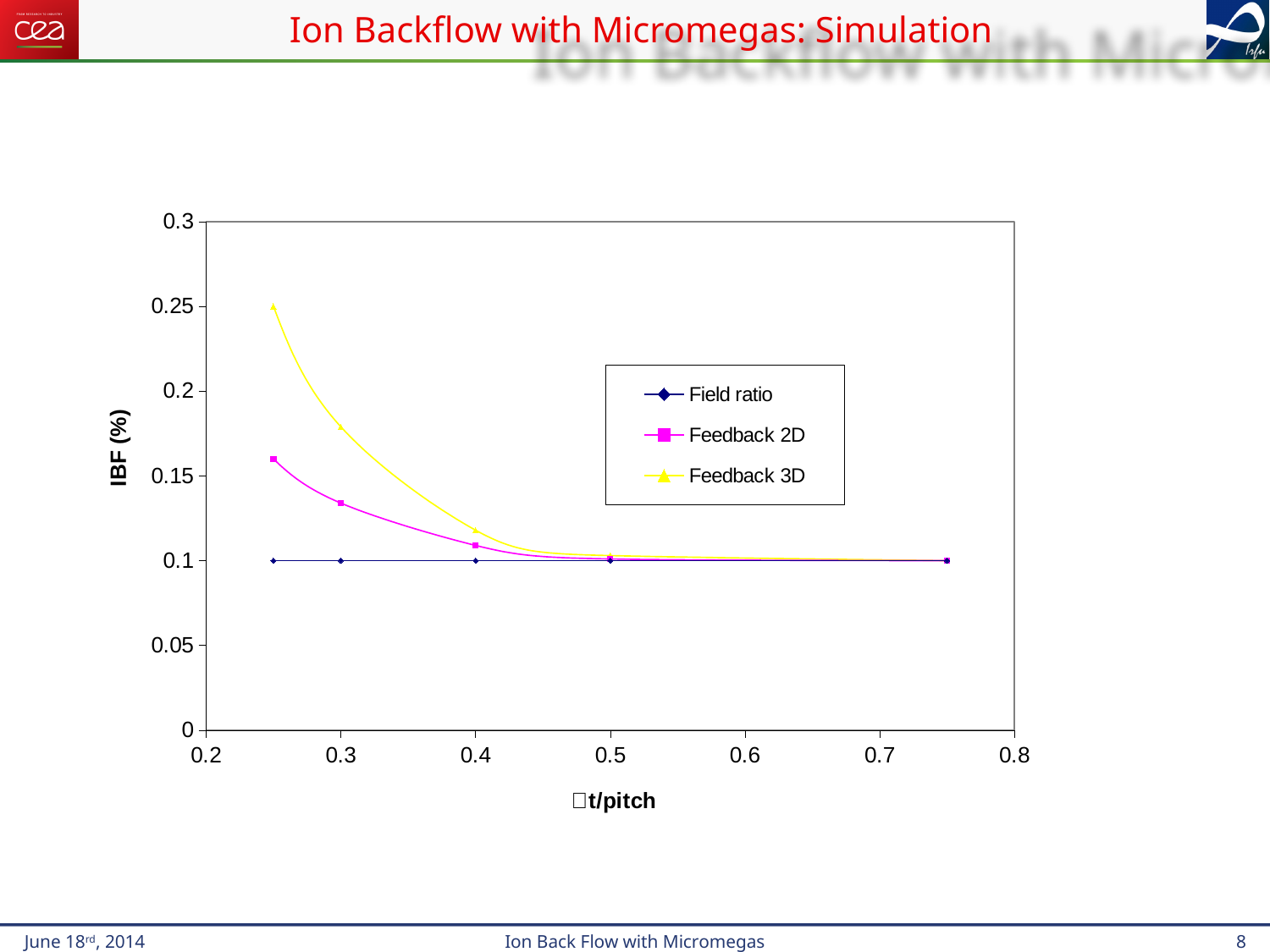
How many series does the legend list? 3 What is the difference between the Feedback 3D value and the Field ratio value at t/pitch = 0.25? 0.15 Does the Feedback 3D series rise or fall as t/pitch increases? fall At t/pitch = 0.25, which series has the higher IBF (%): Feedback 2D or Feedback 3D? Feedback 3D What is the IBF (%) value of the Field ratio series at t/pitch = 0.25? 0.1 Is the Feedback 3D value at t/pitch = 0.4 greater or less than 0.15? less What kind of chart is shown on the slide? line chart Is the Feedback 2D value at t/pitch = 0.3 greater or less than 0.15? less What is the label of the y axis? IBF (%) What are the three series named in the legend? Field ratio, Feedback 2D, Feedback 3D What is the IBF (%) value of the Feedback 3D series at t/pitch = 0.25? 0.25 Is the Feedback 2D value at t/pitch = 0.25 greater or less than 0.15? greater